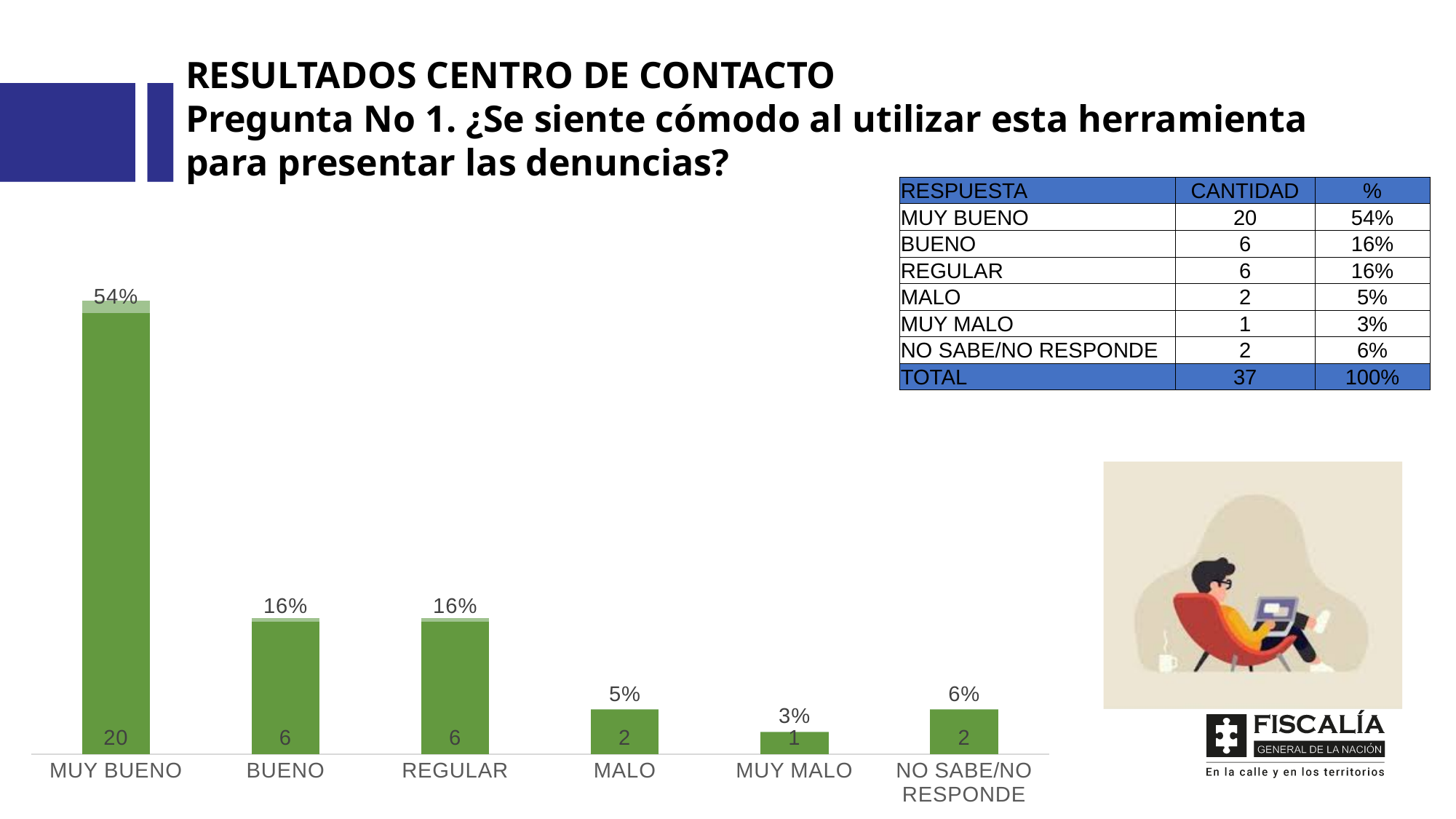
What percentage is shown for MUY BUENO in the bar chart? 54% How many categories are shown on the x axis of the bar chart? 6 Which is larger, the count for MALO or the count for MUY MALO? MALO What kind of chart is shown on the slide? Bar chart What count is shown inside the bar for REGULAR? 6 What count is shown for NO SABE/NO RESPONDE? 2 What percentage is shown for MUY MALO? 3% What colour are the bars in the chart? Green What is the difference in percentage between MALO and NO SABE/NO RESPONDE? 1% Which category has the highest bar? MUY BUENO Which category has the lowest bar? MUY MALO What is the difference in count between MUY BUENO and BUENO? 14